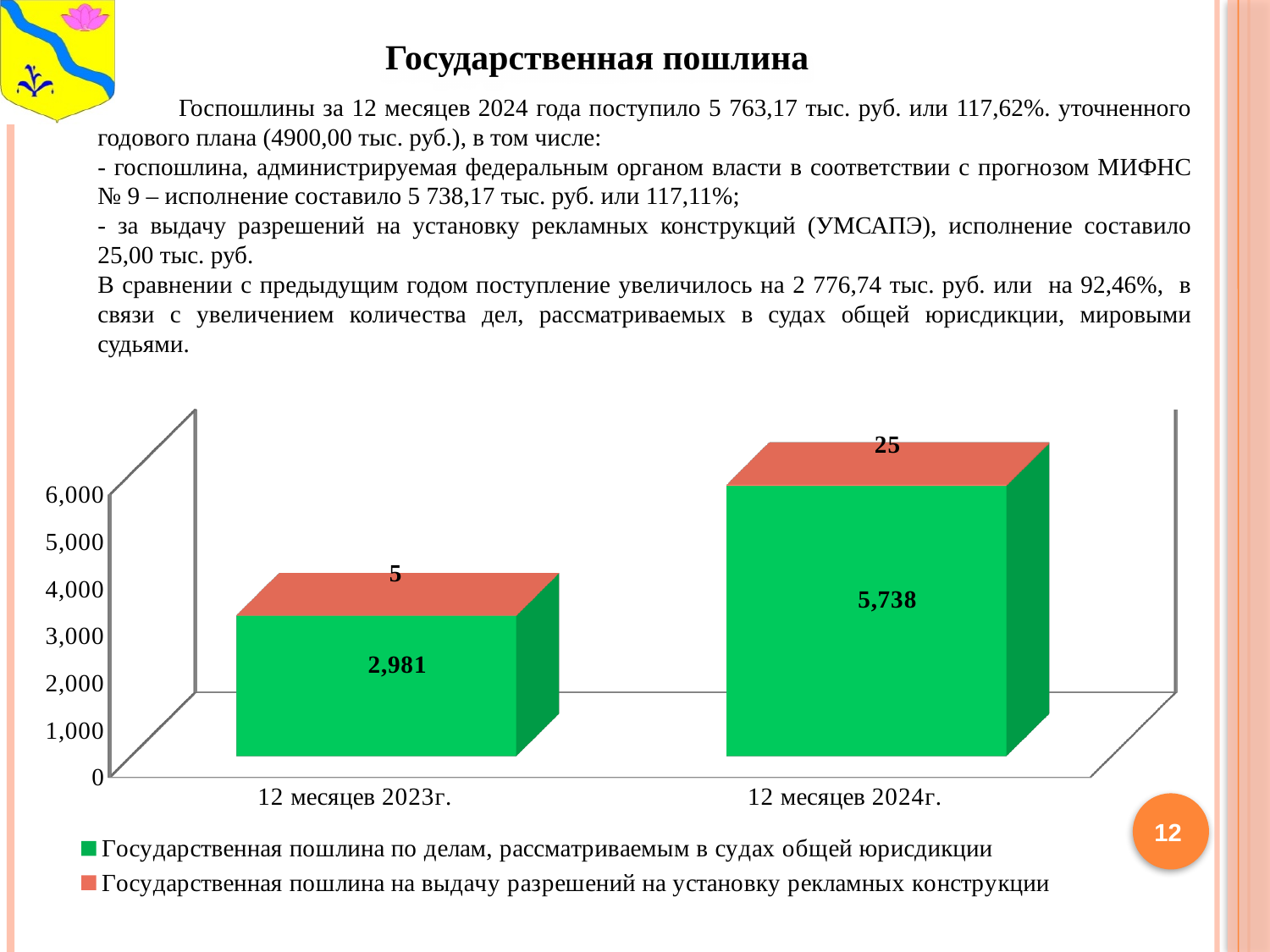
What kind of chart is shown on the slide? Stacked bar chart How many series does the legend list? 2 What is the value of the green series (Государственная пошлина по делам, рассматриваемым в судах общей юрисдикции) for 12 месяцев 2023г.? 2,981 What is the value of the green series (Государственная пошлина по делам, рассматриваемым в судах общей юрисдикции) for 12 месяцев 2024г.? 5,738 How many categories are shown on the x axis? 2 What is the value of the red series (Государственная пошлина на выдачу разрешений на установку рекламных конструкции) for 12 месяцев 2024г.? 25 What is the total of the stacked bar for 12 месяцев 2023г.? 2,986 Which category has the lower value for the red series? 12 месяцев 2023г. What is the difference between the green series values for 12 месяцев 2024г. and 12 месяцев 2023г.? 2,757 Which category has the higher value for the green series? 12 месяцев 2024г. What is the total of the stacked bar for 12 месяцев 2024г.? 5,763 What is the value of the red series (Государственная пошлина на выдачу разрешений на установку рекламных конструкции) for 12 месяцев 2023г.? 5